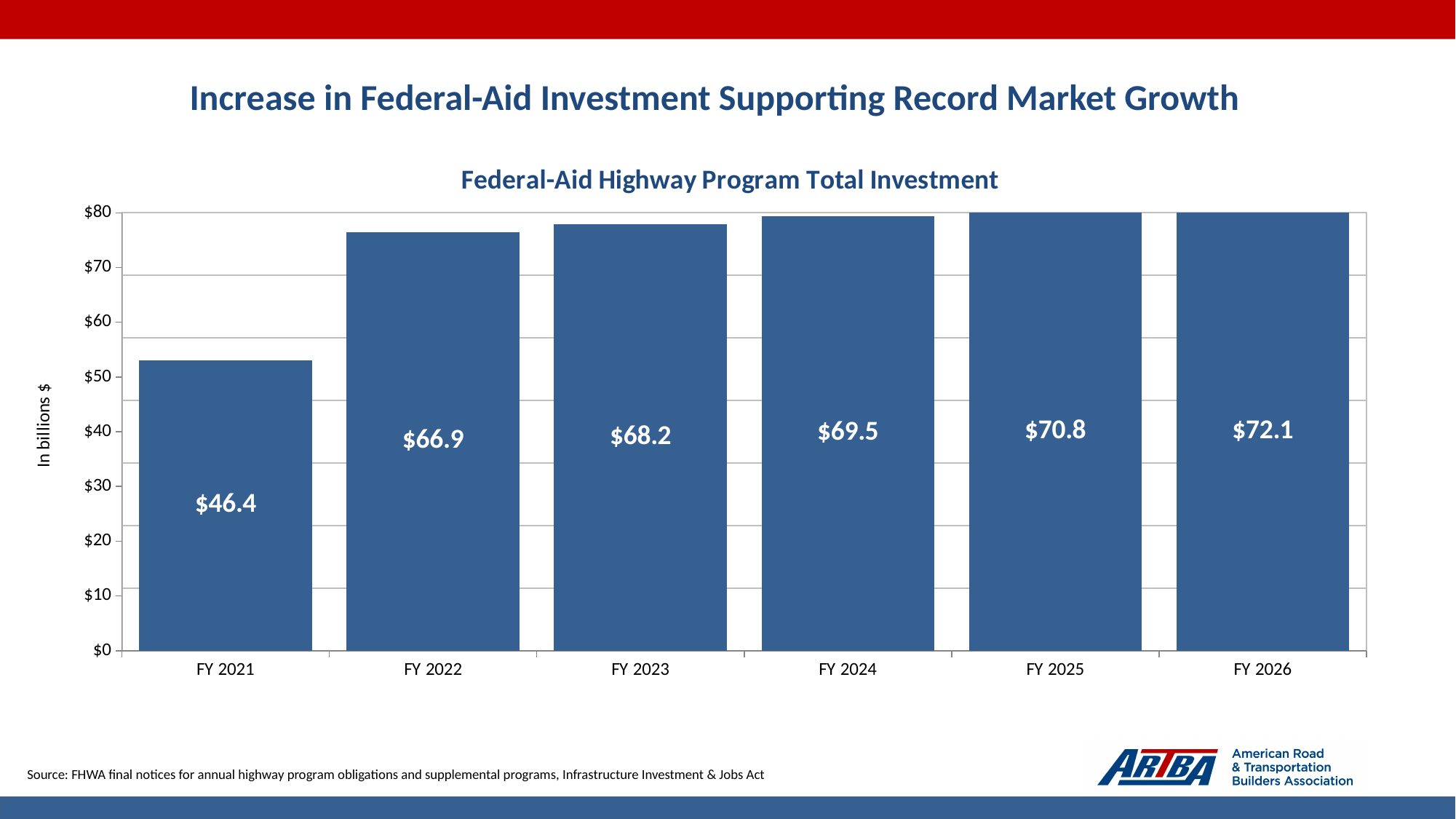
How many fiscal years are shown on the chart? 6 What kind of chart is shown on the slide? bar chart Which fiscal year has the highest value? FY 2026 What is the value for FY 2026? $72.1 Is the value for FY 2021 greater or less than $60? less What is the difference between the values for FY 2026 and FY 2021? $25.7 What is the value for FY 2024? $69.5 Which fiscal year has the lowest value? FY 2021 Which is larger, the value for FY 2023 or the value for FY 2025? FY 2025 What is the difference between the values for FY 2022 and FY 2021? $20.5 What is the value for FY 2021? $46.4 Do the values rise or fall from FY 2021 to FY 2026? rise